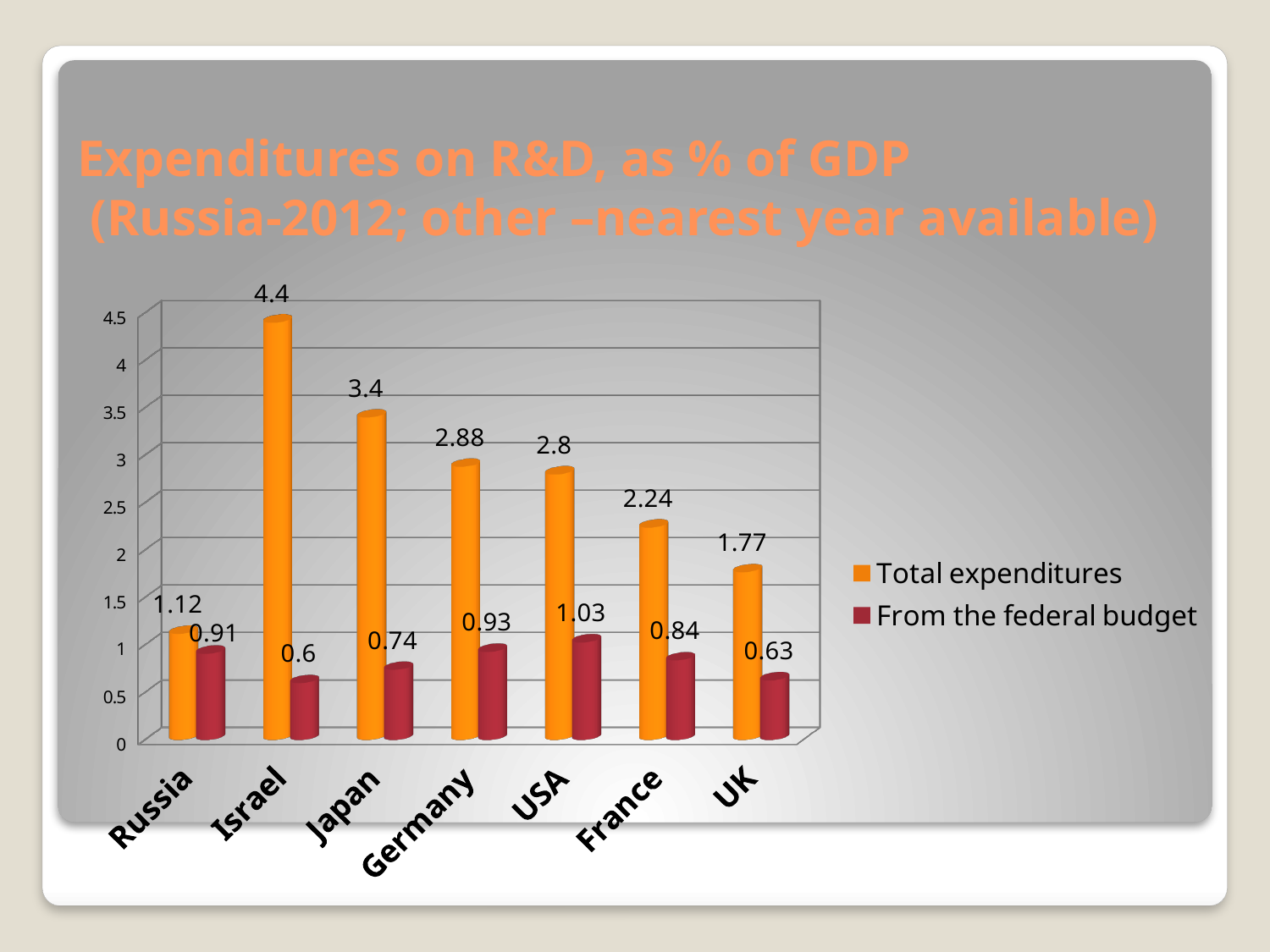
Which country has the highest Total expenditures? Israel What is the difference between Total expenditures for Japan and Germany? 0.52 What is the value of Total expenditures for France? 2.24 What kind of chart is shown on the slide? Bar chart Which country has the lowest From the federal budget value? Israel What is the value of From the federal budget for USA? 1.03 What is the value of Total expenditures for Israel? 4.4 How many countries are shown on the x axis? 7 How many series does the legend list? 2 Which is larger: From the federal budget for Russia or for Germany? Germany Do the Total expenditures values rise or fall from Israel to UK along the x axis? Fall Which colour represents the From the federal budget series? Dark red